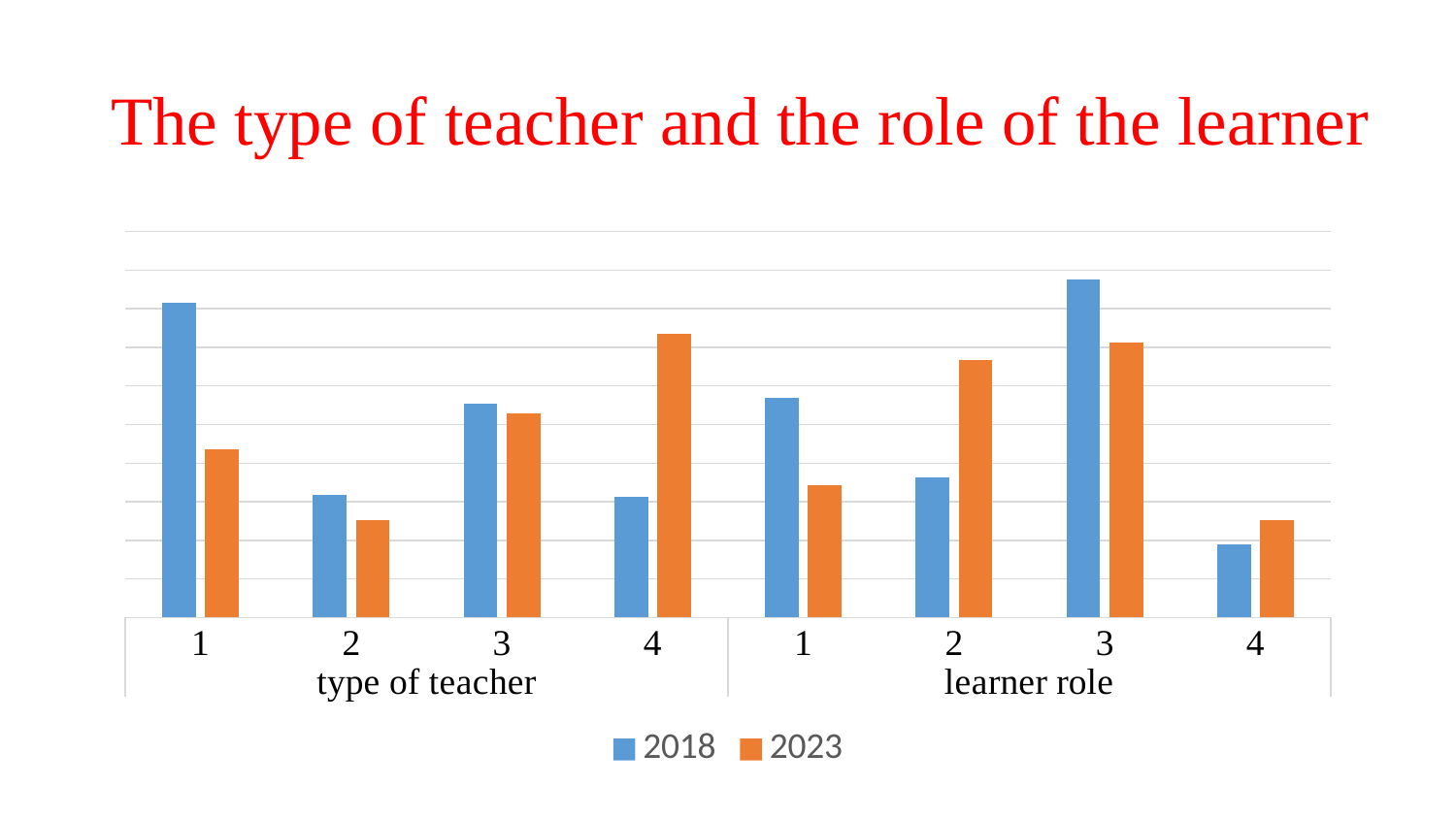
What is the title of the slide? The type of teacher and the role of the learner How many categories are plotted along the x axis in total? 8 Which category has the lowest 2018 value across the whole chart? learner role 4 Within the 'type of teacher' group, which category has the highest 2018 value? 1 Which colour represents the 2023 series? orange For type of teacher 1, which series is larger, 2018 or 2023? 2018 Which category has the highest 2018 value across the whole chart? learner role 3 For type of teacher 4, which series is larger, 2018 or 2023? 2023 What kind of chart is shown on the slide? bar chart How many categories are in the 'type of teacher' group? 4 For learner role 2, which series is larger, 2018 or 2023? 2023 How many series does the legend list? 2